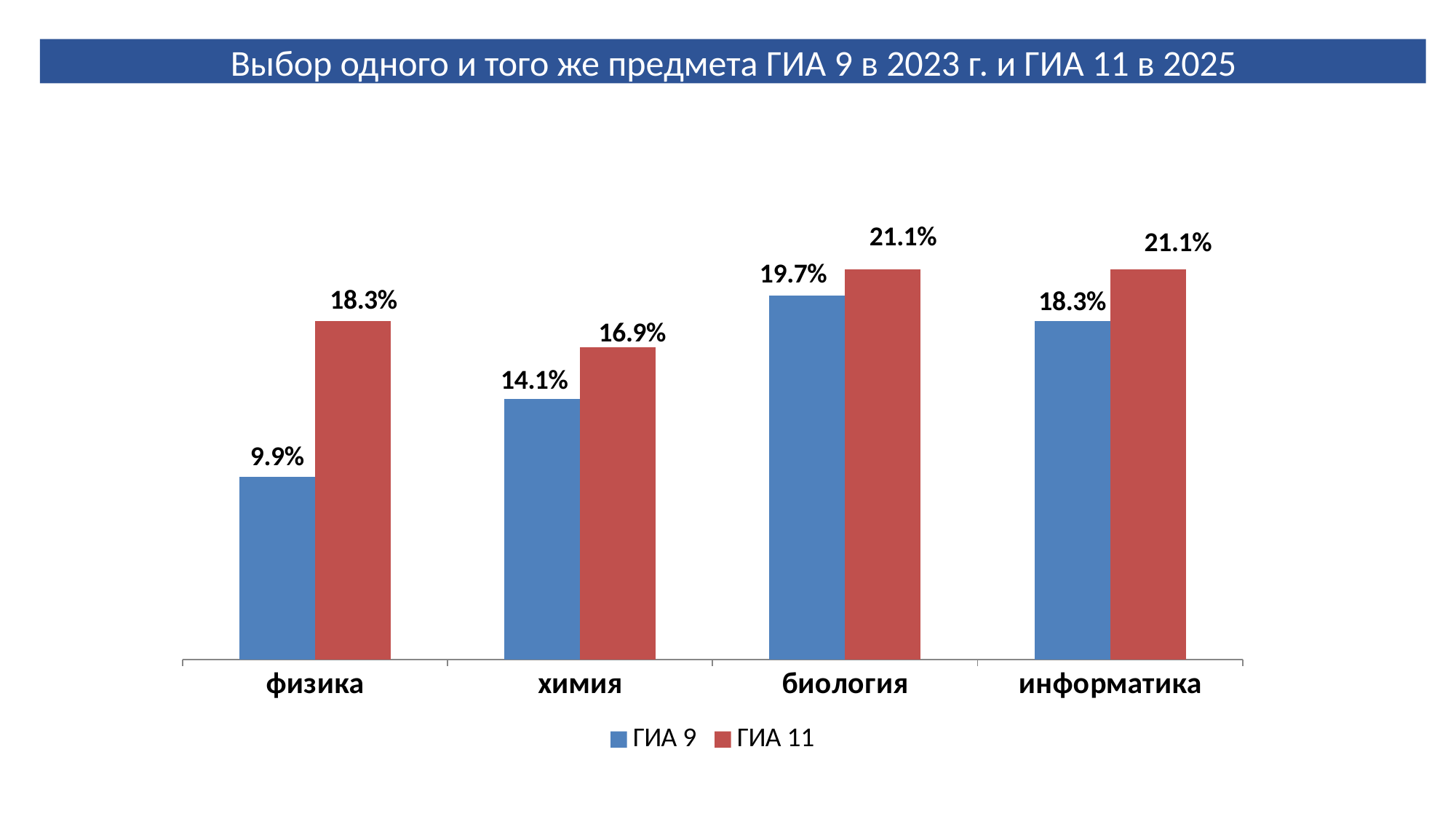
Which category has the lowest ГИА 9 value? физика What is the difference between the ГИА 11 and ГИА 9 values for физика? 8.4% Which category has the lowest ГИА 11 value? химия What is the ГИА 11 value for информатика? 21.1% How many series does the legend list? 2 What is the ГИА 11 value for химия? 16.9% Which category has the highest ГИА 9 value? биология Which is larger for информатика: the ГИА 9 value or the ГИА 11 value? ГИА 11 What is the ГИА 9 value for биология? 19.7% What kind of chart is shown on the slide? bar chart What is the ГИА 9 value for физика? 9.9% How many categories are shown on the x axis? 4